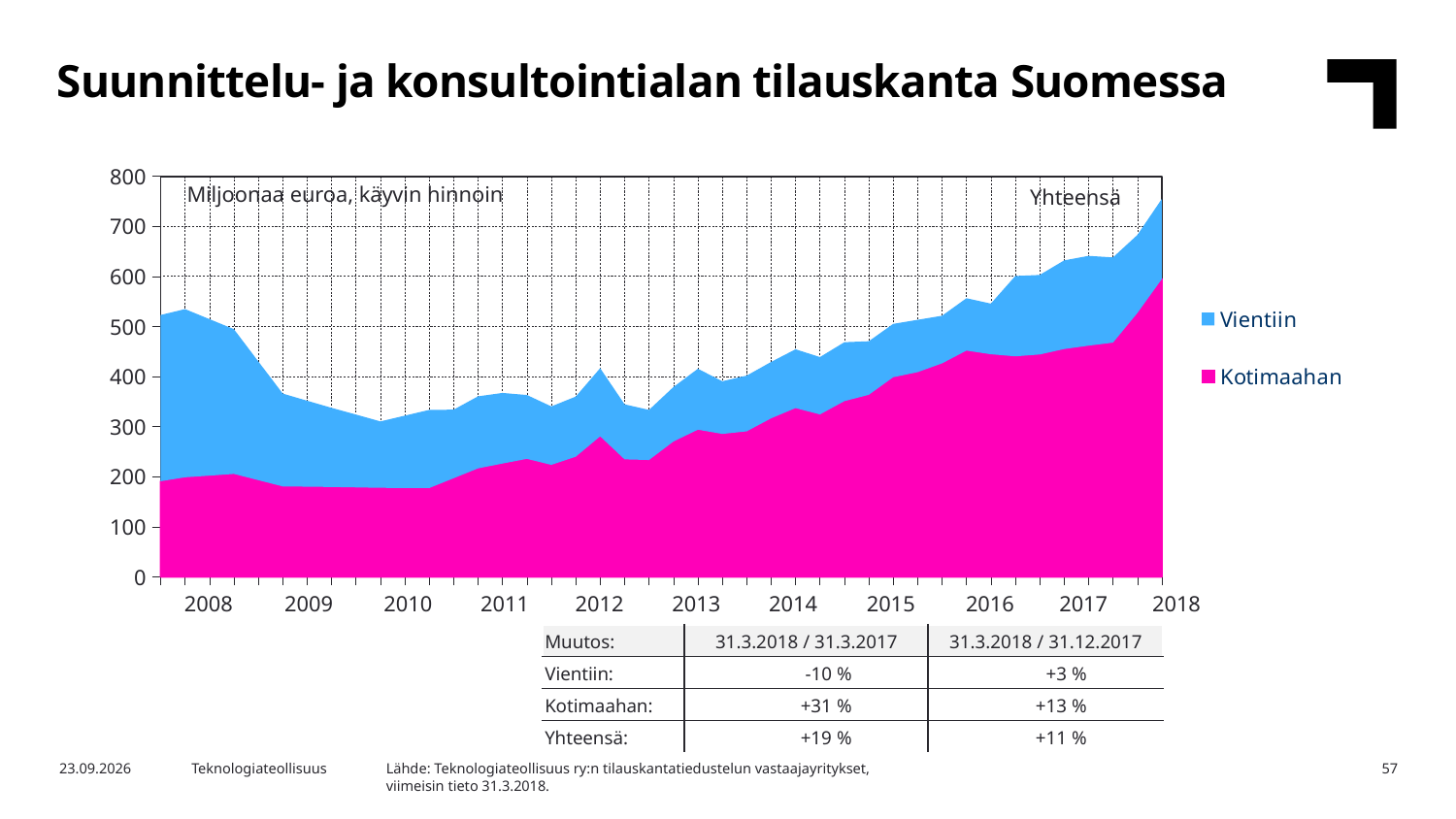
Is the Kotimaahan value around 2010 greater or less than 200? less Is the total (Yhteensä) value larger at the start of 2008 or at the end of the chart in 2018? 2018 What unit is stated in the chart's subtitle? Miljoonaa euroa, käyvin hinnoin Is the total (Yhteensä) value at the end of the chart (2018) greater or less than 700? greater According to the table below the chart, what is the change in Kotimaahan for 31.3.2018 / 31.3.2017? +31 % How many series does the chart legend list? 2 Does the total (Yhteensä) value rise or fall between 2008 and 2010? fall What kind of chart is shown on the slide? Stacked area chart What are the two series named in the chart legend? Vientiin and Kotimaahan Is the Kotimaahan value at the end of the chart (2018) greater or less than 500? greater Does the Kotimaahan value rise or fall between 2013 and 2018? rise